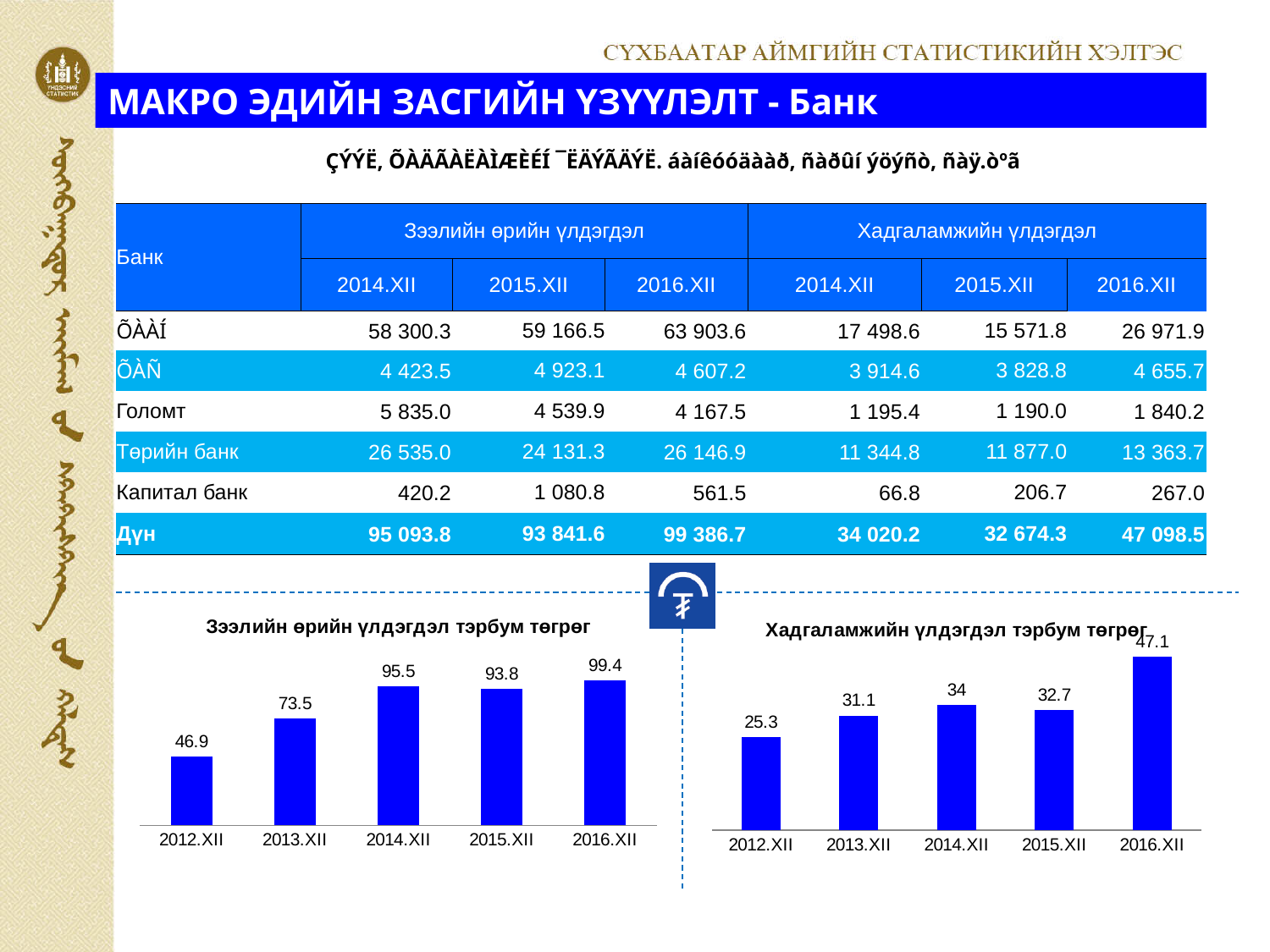
In the chart titled 'Хадгаламжийн үлдэгдэл тэрбум төгрөг', which year has the lowest value? 2012.XII What type of chart is the chart titled 'Хадгаламжийн үлдэгдэл тэрбум төгрөг'? Bar chart In the chart titled 'Хадгаламжийн үлдэгдэл тэрбум төгрөг', what is the value for 2016.XII? 47.1 In the chart titled 'Зээлийн өрийн үлдэгдэл тэрбум төгрөг', what is the value for 2015.XII? 93.8 In the chart titled 'Зээлийн өрийн үлдэгдэл тэрбум төгрөг', what is the difference between the values for 2013.XII and 2012.XII? 26.6 In the chart titled 'Зээлийн өрийн үлдэгдэл тэрбум төгрөг', how many bars are plotted? 5 In the chart titled 'Хадгаламжийн үлдэгдэл тэрбум төгрөг', what is the difference between the values for 2016.XII and 2015.XII? 14.4 In the chart titled 'Зээлийн өрийн үлдэгдэл тэрбум төгрөг', which year has the highest value? 2016.XII In the chart titled 'Зээлийн өрийн үлдэгдэл тэрбум төгрөг', what is the value for 2012.XII? 46.9 In the chart titled 'Хадгаламжийн үлдэгдэл тэрбум төгрөг', which is larger, the value for 2014.XII or 2015.XII? 2014.XII In the chart titled 'Хадгаламжийн үлдэгдэл тэрбум төгрөг', what is the value for 2014.XII? 34 In the chart titled 'Зээлийн өрийн үлдэгдэл тэрбум төгрөг', which year has the lowest value? 2012.XII